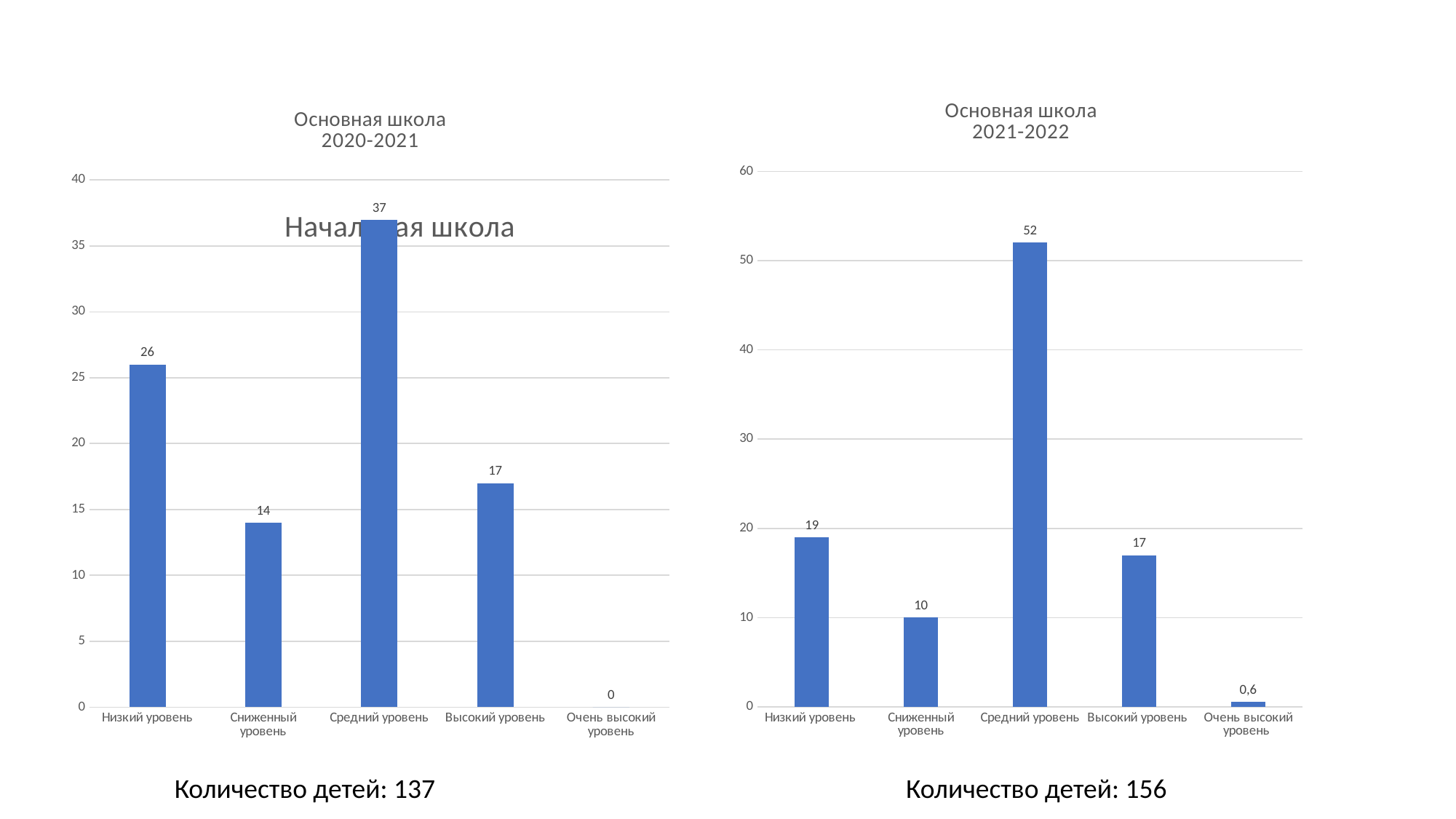
How many categories are shown in the 'Основная школа 2021-2022' chart? 5 In the 'Основная школа 2021-2022' chart, which category has the lowest value? Очень высокий уровень In the 'Основная школа 2020-2021' chart, what is the value for Средний уровень? 37 What kind of chart is the 'Основная школа 2020-2021' chart? bar chart In the 'Основная школа 2020-2021' chart, what is the difference between Низкий уровень and Сниженный уровень? 12 In the 'Основная школа 2020-2021' chart, is the value for Высокий уровень greater or less than 20? less In the 'Основная школа 2020-2021' chart, which category has the highest value? Средний уровень What is the title of the chart on the right side of the slide? Основная школа 2021-2022 In the 'Основная школа 2021-2022' chart, which is larger: Низкий уровень or Сниженный уровень? Низкий уровень In the 'Основная школа 2021-2022' chart, what is the difference between Средний уровень and Высокий уровень? 35 In the 'Основная школа 2021-2022' chart, what is the value for Очень высокий уровень? 0,6 In the 'Основная школа 2020-2021' chart, what is the value for Сниженный уровень? 14